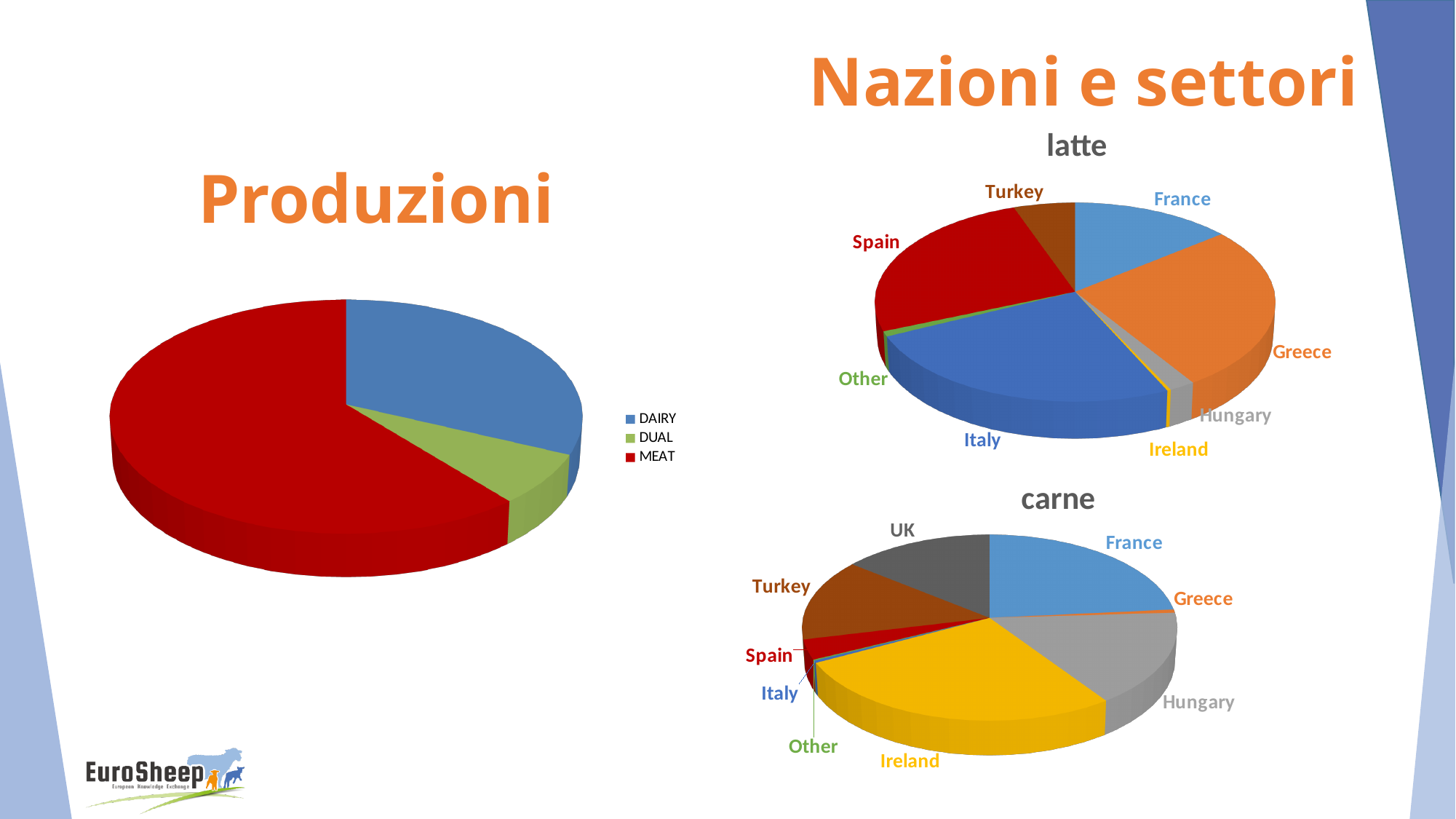
How many countries/categories are labelled in the "latte" pie chart? 8 What kind of chart is the "Produzioni" chart on the left of the slide? pie chart In the "carne" chart, which category has the largest slice? Ireland How many countries/categories are labelled in the "carne" pie chart? 9 How many pie charts are shown on the slide? 3 In the "latte" chart, which slice is larger, Spain or Turkey? Spain In the "Produzioni" chart, which category has the largest slice? MEAT In the "Produzioni" chart, which slice is larger, DAIRY or DUAL? DAIRY In the "Produzioni" chart, which category has the smallest slice? DUAL In the "carne" chart, which slice is larger, UK or Spain? UK How many entries does the legend of the "Produzioni" chart list? 3